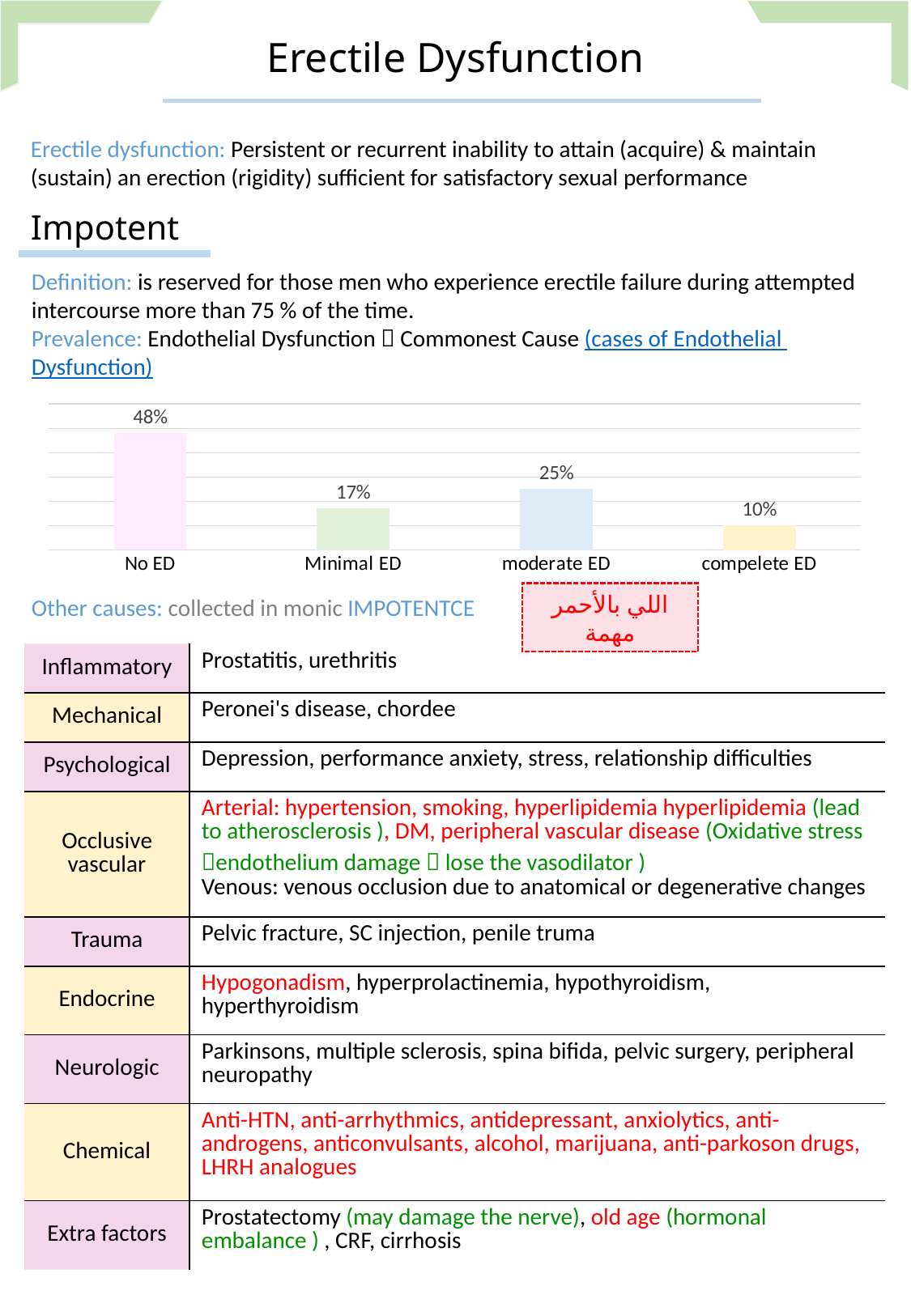
How many categories are shown in the chart? 4 What is the difference between the values for Minimal ED and compelete ED? 7% What is the value for No ED? 48% What kind of chart is shown on the slide? Bar chart What is the value for compelete ED? 10% What is the value for moderate ED? 25% Which is larger, the value for Minimal ED or the value for moderate ED? moderate ED Which category has the lowest value? compelete ED What is the value for Minimal ED? 17% Which category has the highest value? No ED What is the label of the category with the green bar? Minimal ED What is the difference between the values for No ED and moderate ED? 23%